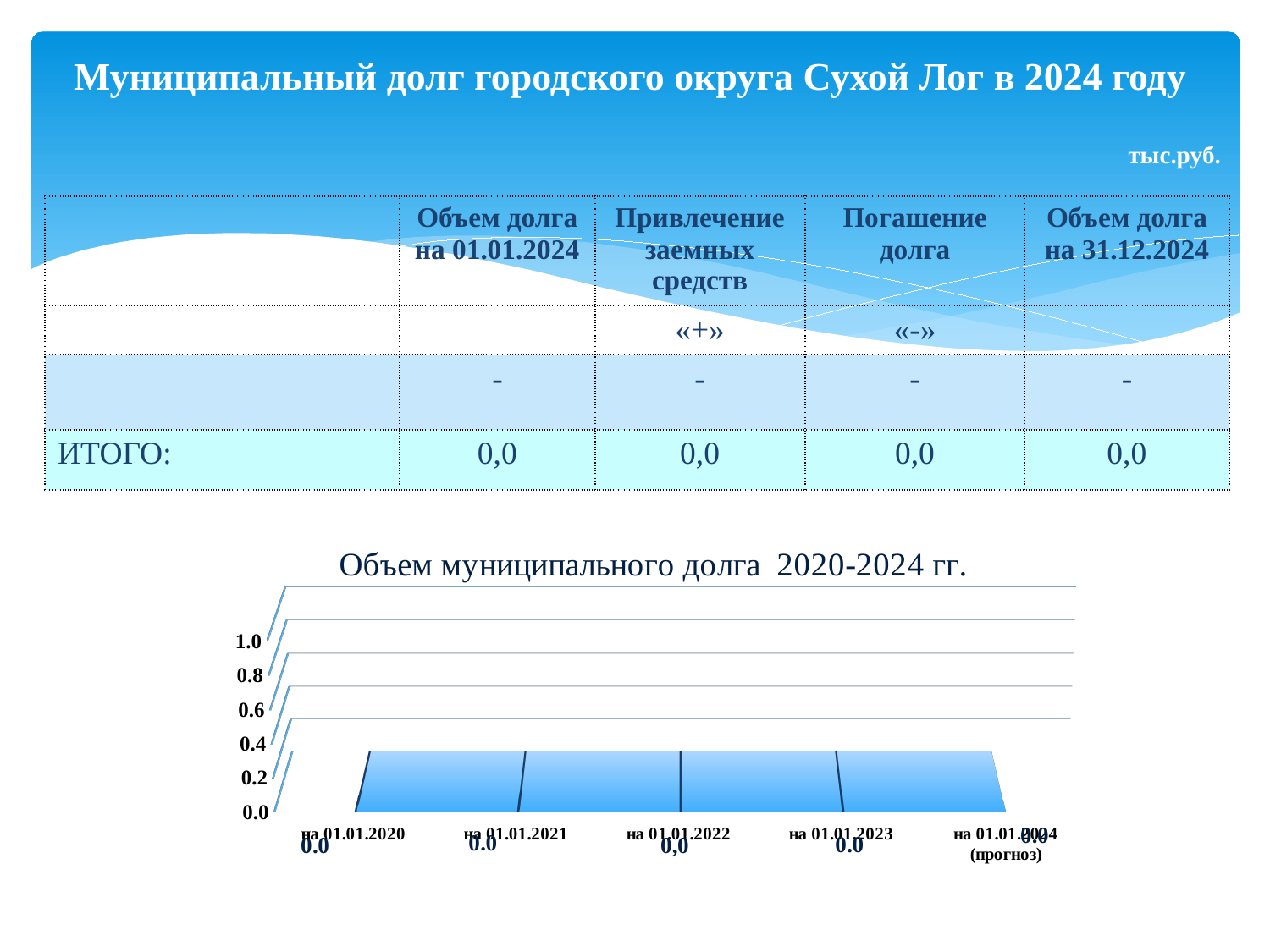
What is the value shown for на 01.01.2022 in the chart? 0,0 What is the value shown for на 01.01.2020 in the chart? 0.0 What is the value shown for на 01.01.2021 in the chart? 0.0 What is the value shown for на 01.01.2023 in the chart? 0.0 What is the difference between the values for на 01.01.2020 and на 01.01.2024 (прогноз)? 0.0 How many categories (dates) are shown on the x axis of the chart? 5 What is the highest tick value shown on the vertical axis of the chart? 1.0 What kind of chart is shown under the table? line chart What is the value shown for на 01.01.2024 (прогноз) in the chart? 0.0 Is the value for на 01.01.2023 greater or less than 0.2? less What is the title of the chart on the slide? Объем муниципального долга 2020-2024 гг. Do the values in the chart rise, fall or stay the same from 01.01.2020 to 01.01.2024? stay the same